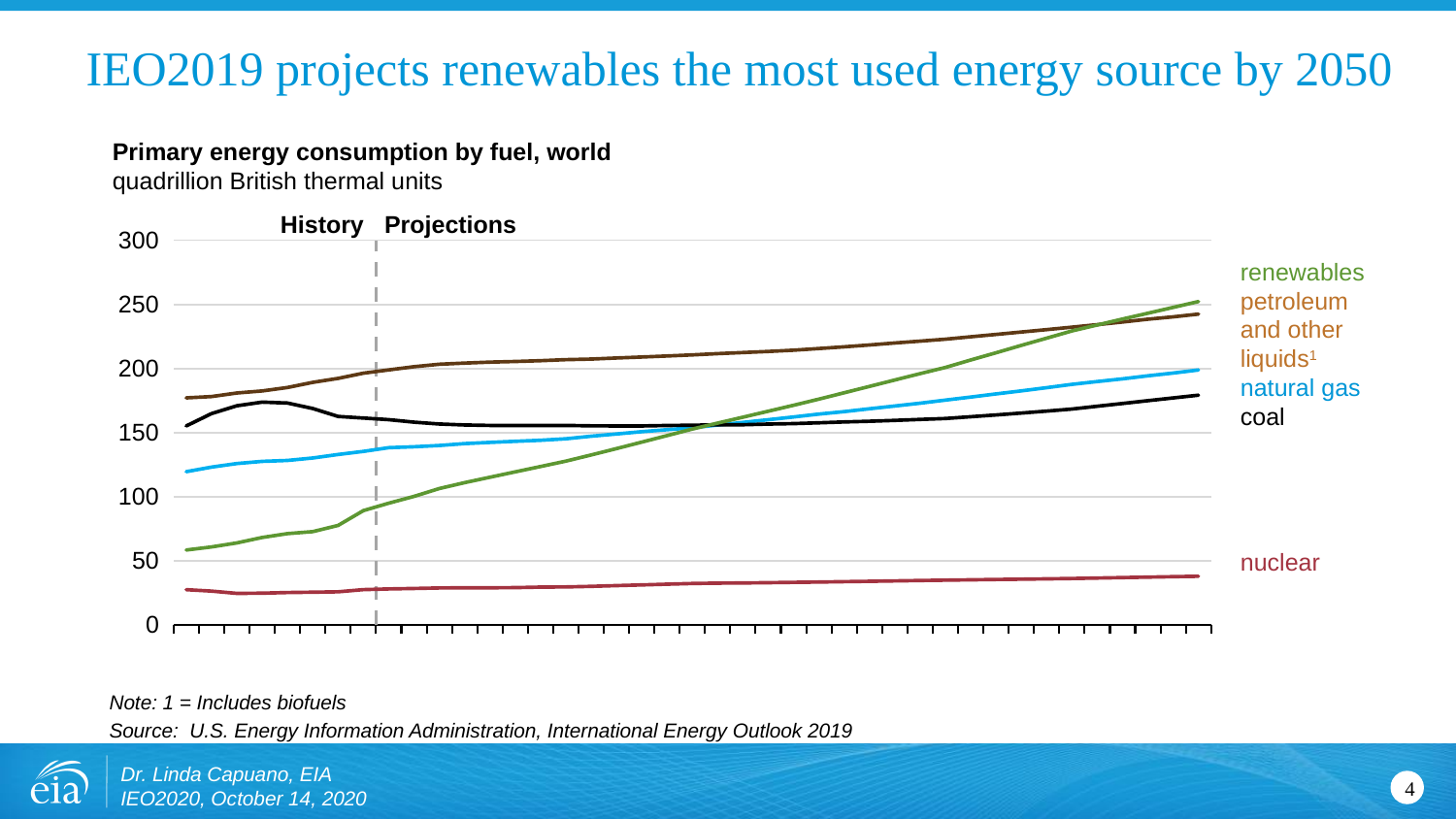
Is the value for renewables at the left end of the chart greater or less than 100? less Which fuel has the lowest primary energy consumption across the whole chart? nuclear Is the value for nuclear at the right end of the chart greater or less than 50? less What unit is the chart measured in? quadrillion British thermal units Which fuel has the highest primary energy consumption at the right end of the projection period? renewables How many fuel series are labelled on the chart? 5 Is the value for natural gas at the left end of the chart greater or less than 100? greater At the right end of the chart, which is larger: natural gas or coal? natural gas What is the title of the chart? Primary energy consumption by fuel, world What kind of chart is shown on the slide? line chart Does the renewables line rise or fall over the projection period? rise